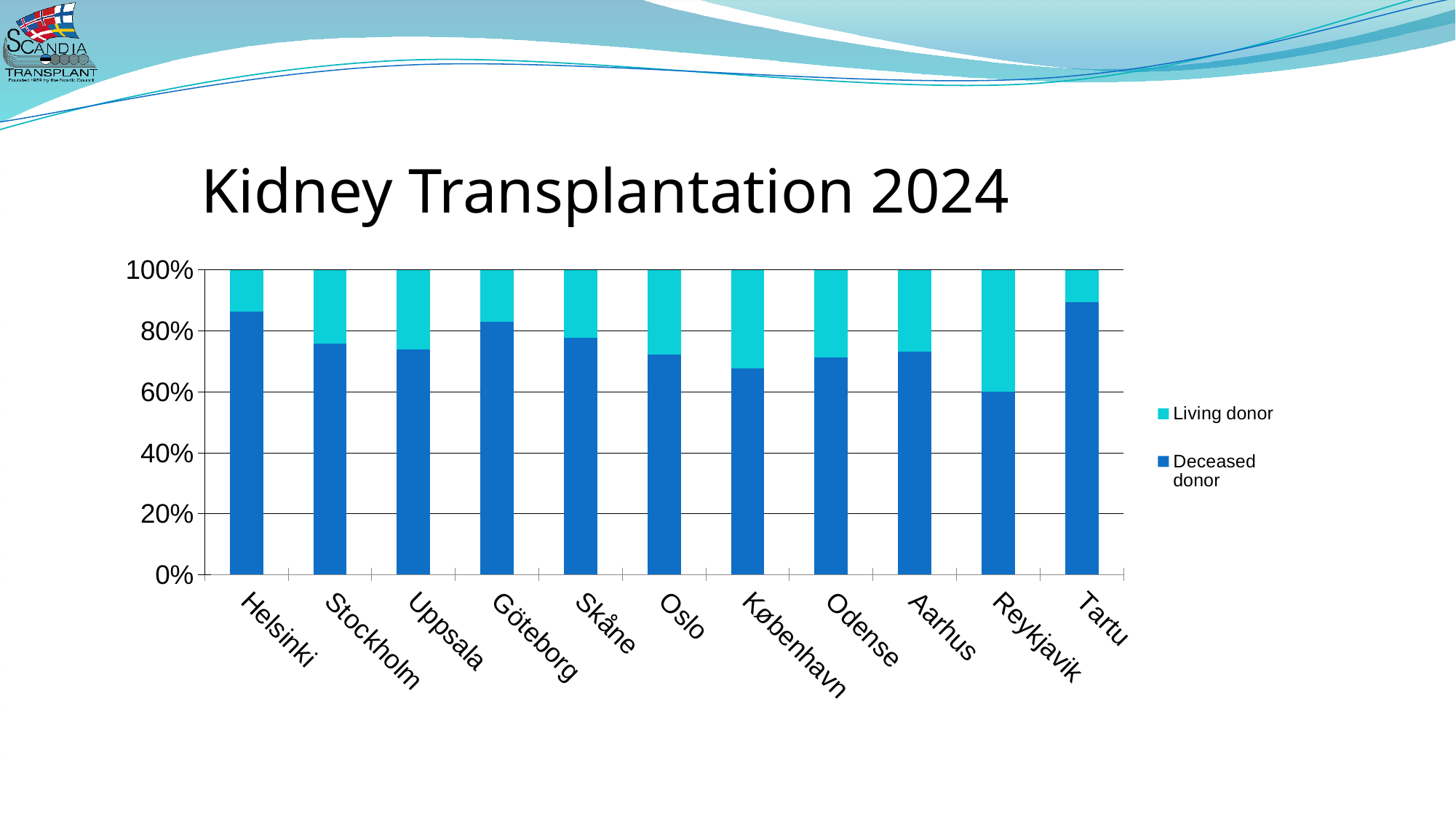
Is the Deceased donor share for Helsinki greater or less than 80%? greater Which centre has the largest Living donor share in the chart? Reykjavik How many series does the chart legend list? 2 What is the title of the chart on the slide? Kidney Transplantation 2024 How many centres (categories) are shown on the x axis of the chart? 11 What kind of chart is shown on the slide? Stacked bar chart Which centre has the largest Deceased donor share in the chart? Tartu What does each stacked bar in the chart total? 100% Is the Deceased donor share for København greater or less than 80%? less Which has the larger Deceased donor share, Göteborg or Oslo? Göteborg Which series is shown in the lighter cyan colour in the chart? Living donor Which centre has the smallest Deceased donor share in the chart? Reykjavik